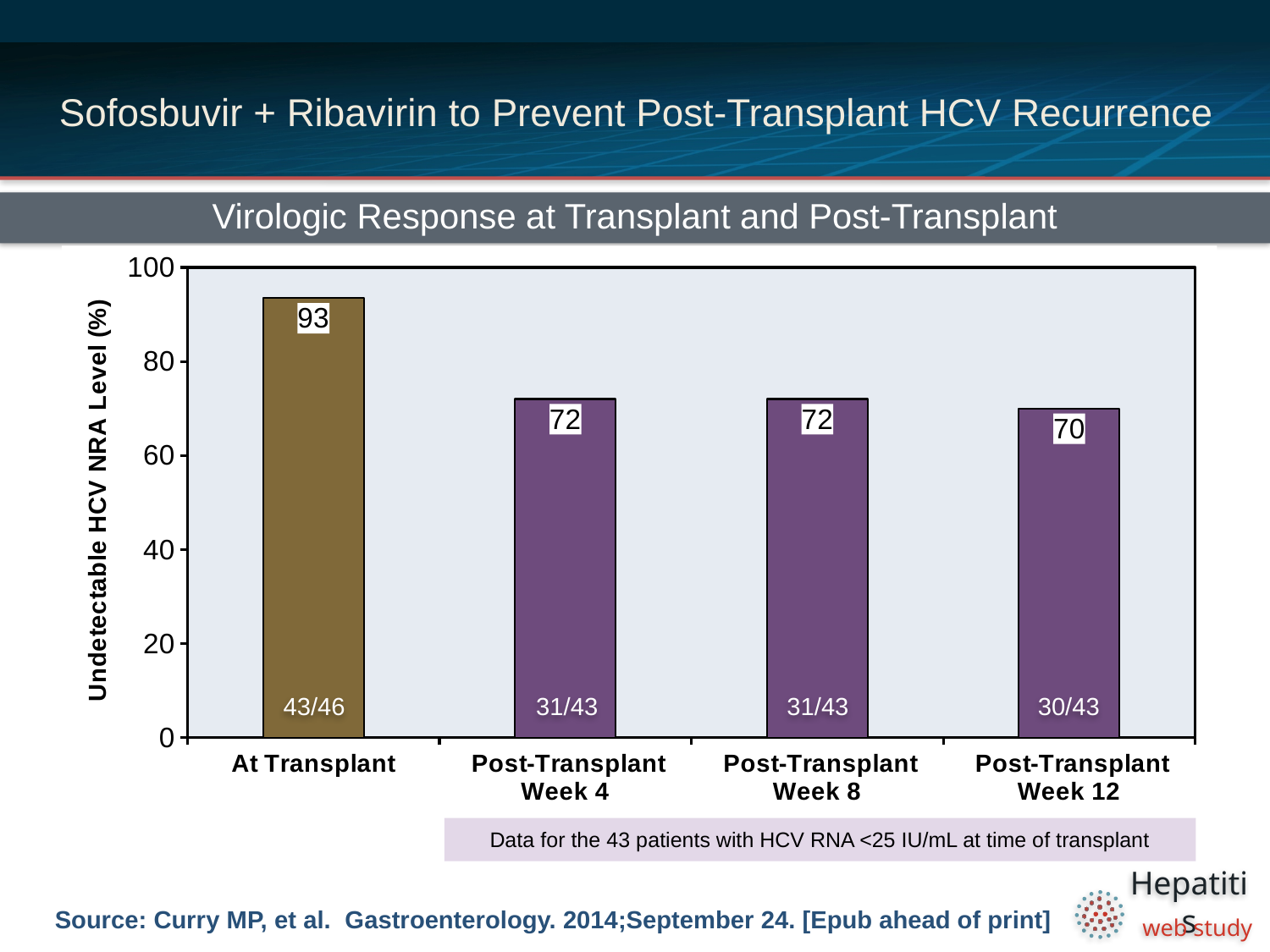
Is the value for Post-Transplant Week 8 greater or less than 80? less What is the value for Post-Transplant Week 12? 70 What is the title of the chart? Virologic Response at Transplant and Post-Transplant What is the value for At Transplant? 93 Which is larger, the value for At Transplant or the value for Post-Transplant Week 8? At Transplant What kind of chart is shown? bar chart What is the value for Post-Transplant Week 4? 72 What is the difference between the values for At Transplant and Post-Transplant Week 4? 21 What fraction of patients is printed on the Post-Transplant Week 12 bar? 30/43 How many categories are shown on the x axis? 4 Which category has the lowest value? Post-Transplant Week 12 Which category has the highest value? At Transplant